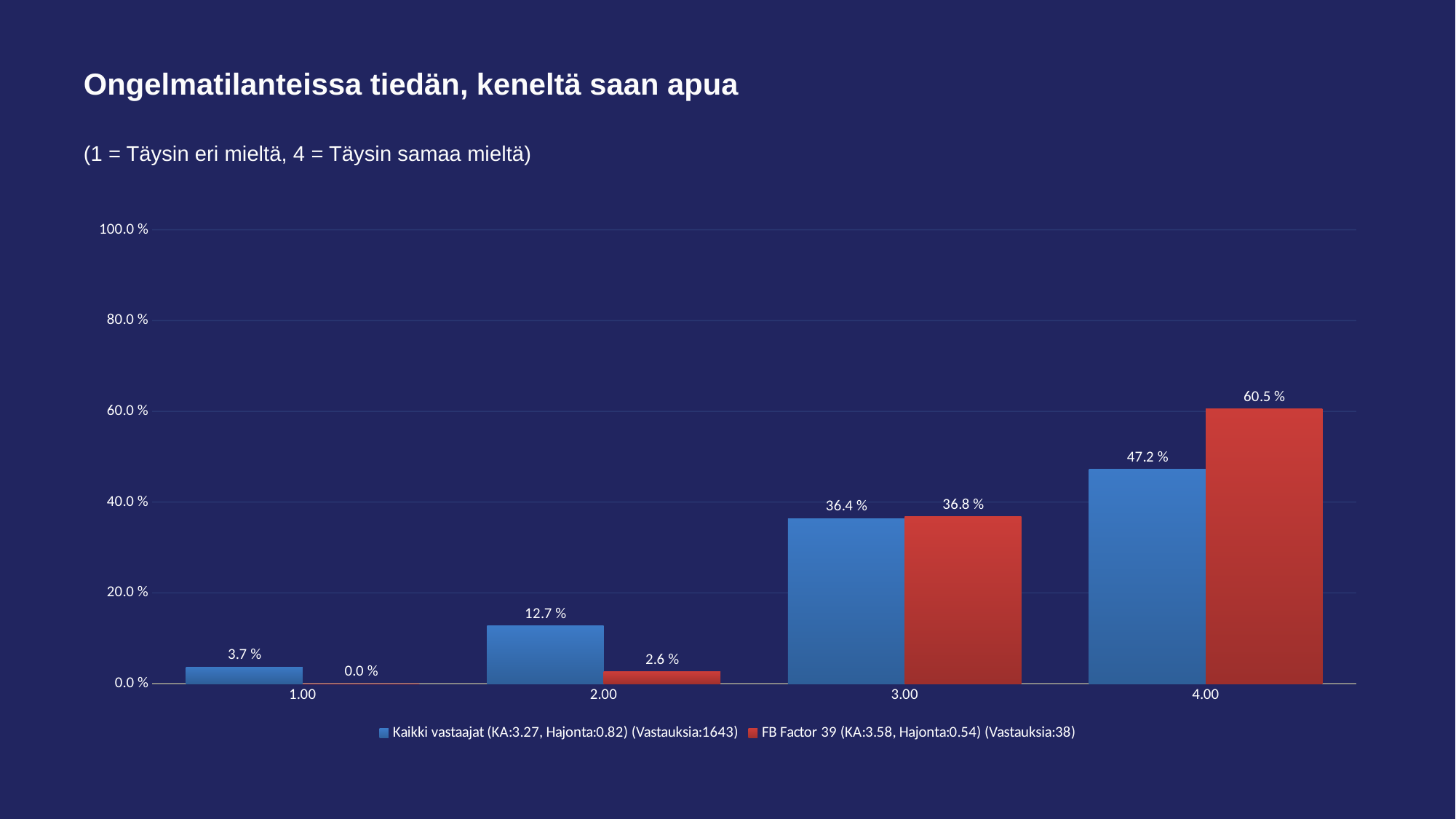
What is the value for FB Factor 39 at 1.00? 0.0 % How many series does the legend list? 2 How many categories are shown on the x axis? 4 Which category has the lowest value for Kaikki vastaajat? 1.00 What is the value for Kaikki vastaajat at 4.00? 47.2 % What kind of chart is shown on the slide? Bar chart Which category has the highest value for FB Factor 39? 4.00 Do the Kaikki vastaajat values rise or fall from 1.00 to 4.00? Rise Is the value for FB Factor 39 at 4.00 greater or less than 60.0 %? greater What is the difference between the FB Factor 39 and Kaikki vastaajat values at 4.00? 13.3 % What is the value for FB Factor 39 at 2.00? 2.6 % Which is larger at 2.00: Kaikki vastaajat or FB Factor 39? Kaikki vastaajat